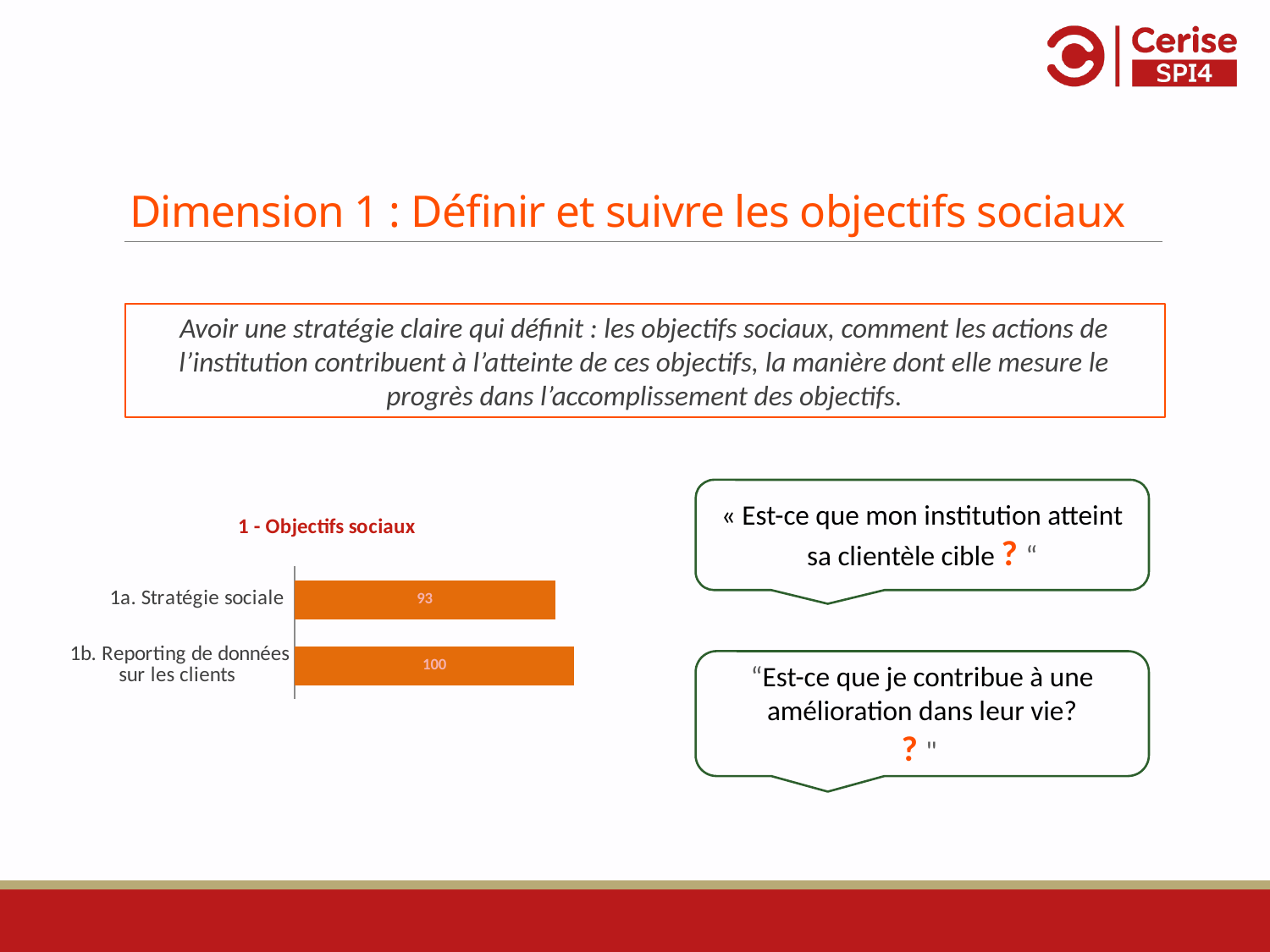
Which category has the lowest value? 1a. Stratégie sociale Which is larger: the value for 1a. Stratégie sociale or 1b. Reporting de données sur les clients? 1b. Reporting de données sur les clients What is the difference between the values for 1b. Reporting de données sur les clients and 1a. Stratégie sociale? 7 What is the value for 1a. Stratégie sociale? 93 How many categories are shown in the chart? 2 What colour are the bars in the chart? Orange What is the value for 1b. Reporting de données sur les clients? 100 What kind of chart is shown on the slide? Bar chart What is the title of the chart? 1 - Objectifs sociaux Which category has the highest value? 1b. Reporting de données sur les clients